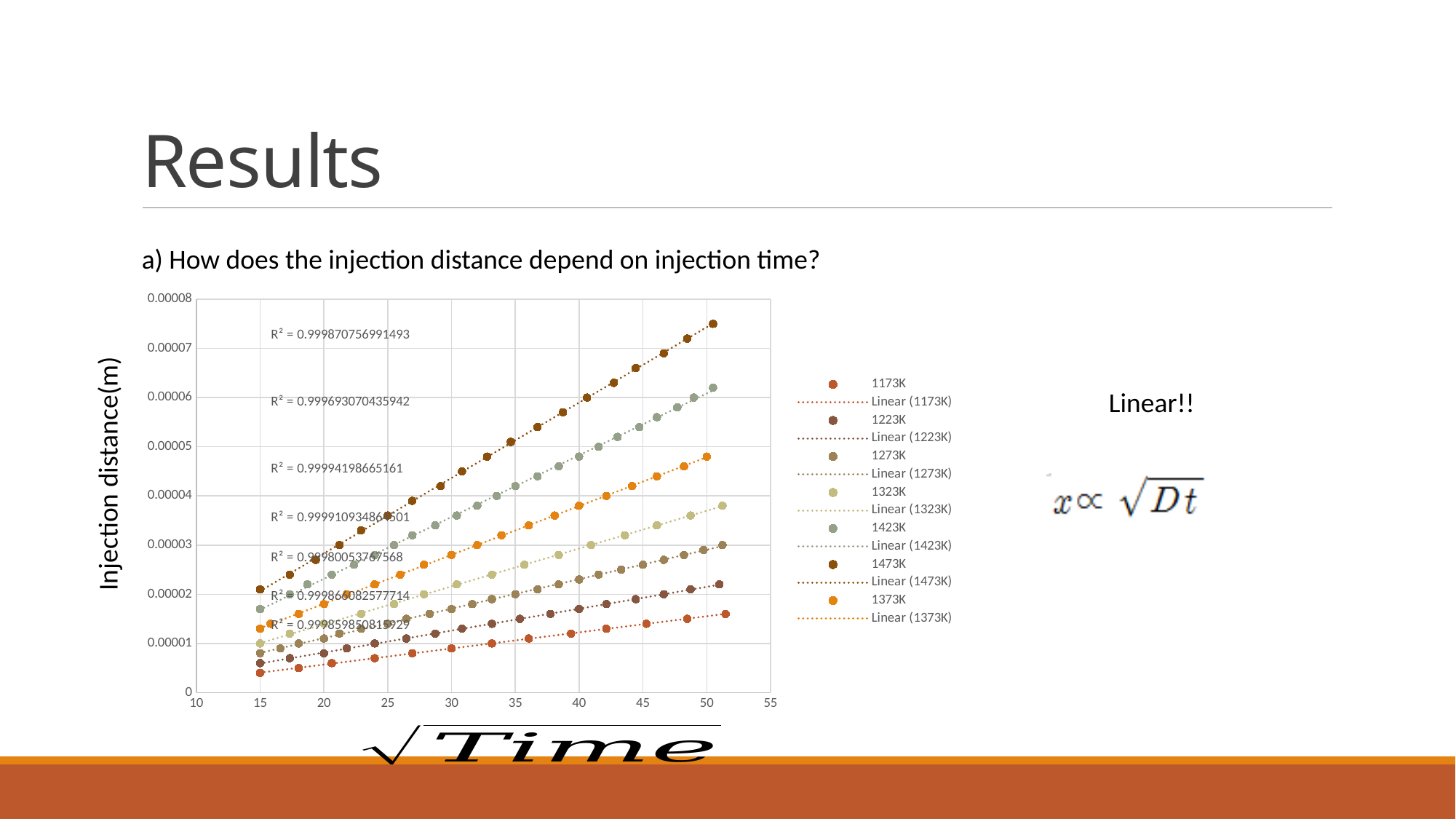
How many entries does the chart legend list? 14 Is the injection distance for the 1173K series at √Time of about 50 greater or less than 0.00002? less At √Time of about 50, which series has the larger injection distance, 1323K or 1273K? 1323K How many temperature series are plotted on the chart? 7 What is the label on the y axis of the chart? Injection distance(m) What kind of chart is shown on the slide? Scatter chart Which temperature series reaches the highest injection distance at the right end of the chart? 1473K Do the injection distance values rise or fall as √Time increases along the x axis? Rise Which temperature series has the lowest injection distance values across the chart? 1173K Is the injection distance for the 1473K series at √Time of about 50 greater or less than 0.00007? greater What is the highest value shown on the y axis of the chart? 0.00008 Is the injection distance for the 1423K series at √Time of about 50 greater or less than 0.00005? greater